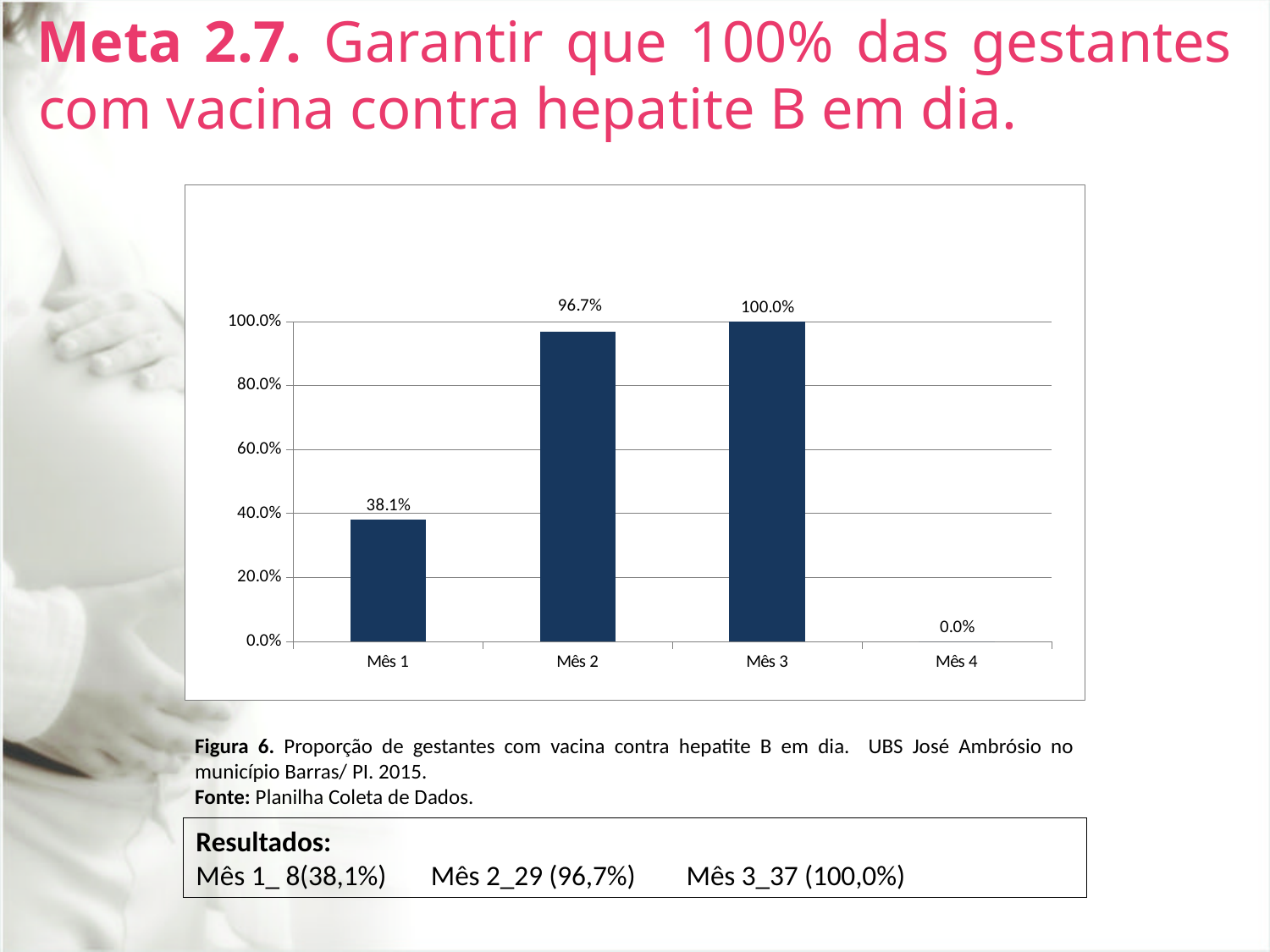
What is the value for Mês 1? 38.1% Is the value for Mês 1 greater or less than 40.0%? less What is the value for Mês 2? 96.7% What is the value for Mês 3? 100.0% Which category has the lowest value? Mês 4 What is the value for Mês 4? 0.0% Which is larger, the value for Mês 1 or the value for Mês 2? Mês 2 Do the values rise or fall from Mês 1 to Mês 3? rise How many categories are shown on the x axis? 4 What is the difference between the values for Mês 2 and Mês 1? 58.6% What kind of chart is shown on the slide? bar chart Which category has the highest value? Mês 3